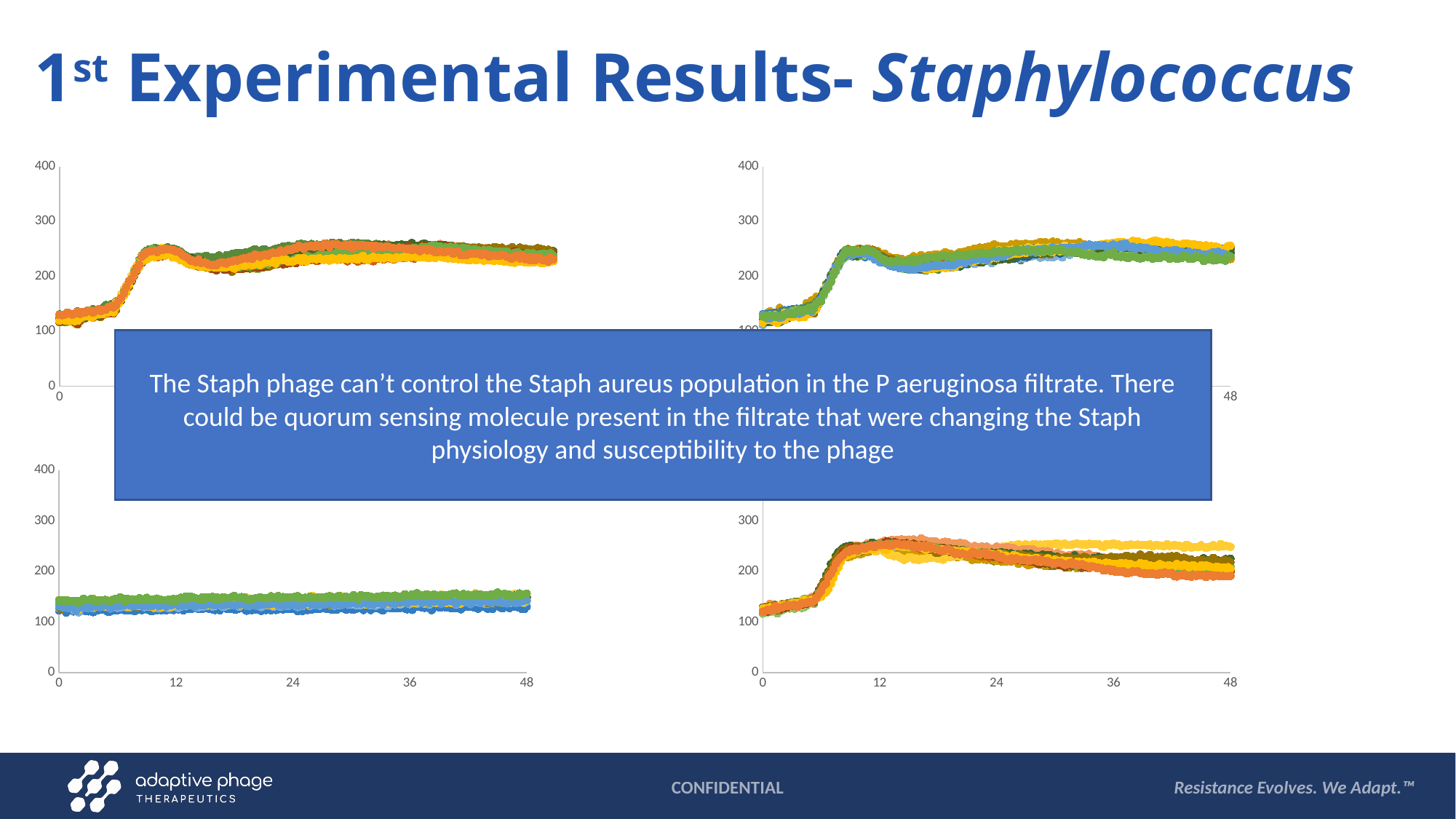
In the bottom-right chart, are the values of the series at x = 0 greater or less than 200? less In the bottom-left chart, is the value of the series at x = 48 greater or less than 200? less In the top-left chart, do the values rise or fall between x = 0 and x = 12? rise In the top-right chart, are the values of the series at x = 0 greater or less than 200? less In the bottom-right chart, does the orange series rise or fall between x = 12 and x = 48? fall How many charts are shown on the slide? 4 What kind of chart is the top-left chart on the slide? line chart What is the last tick label on the x axis of the bottom-left chart? 48 What is the highest value shown on the y axis of the bottom-right chart? 400